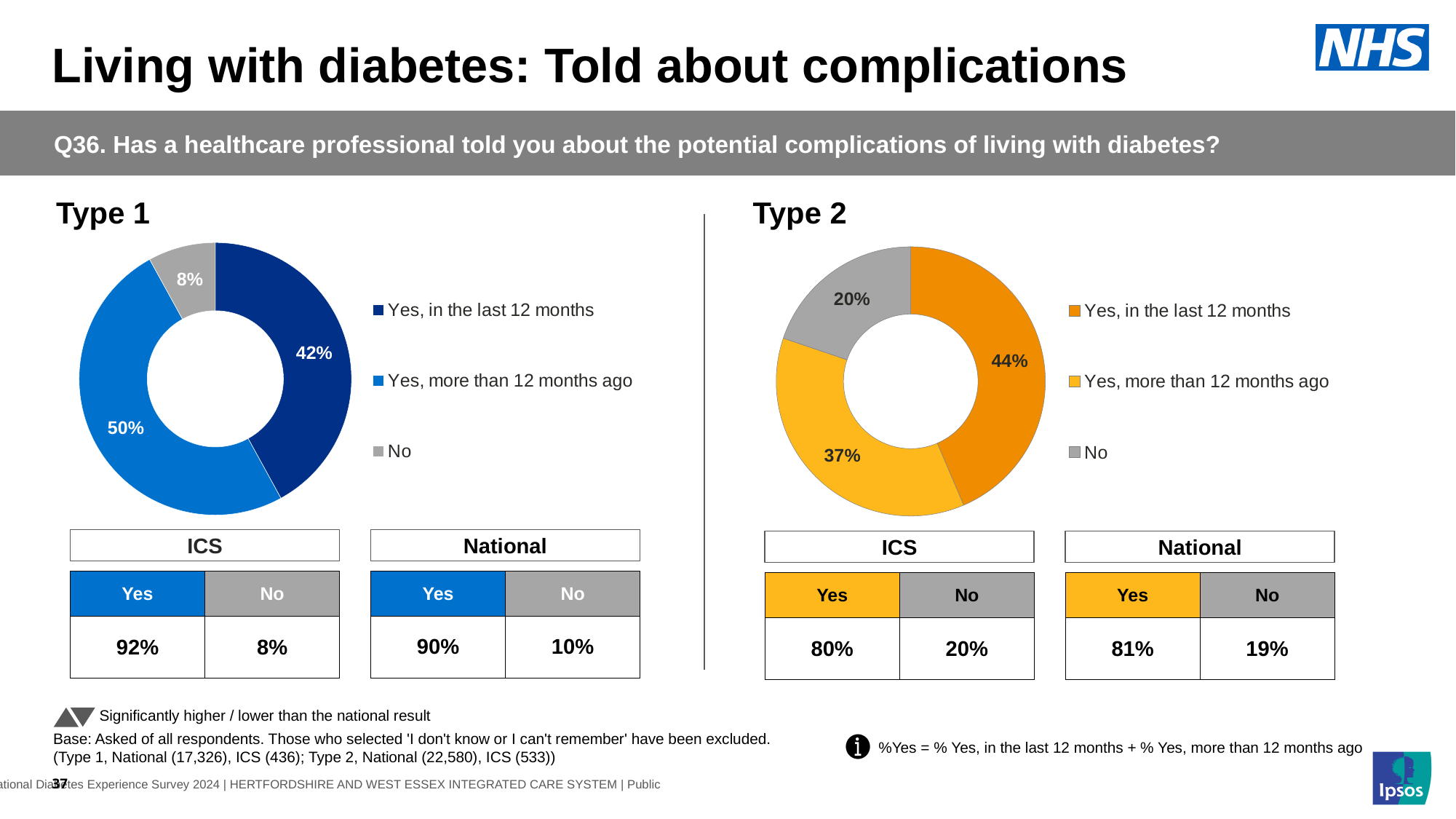
In the Type 2 chart, which category has the smallest share? No In the Type 1 chart, which category has the largest share? Yes, more than 12 months ago In the Type 2 chart, what percentage of respondents answered 'No'? 20% In the Type 1 chart, what percentage of respondents answered 'Yes, in the last 12 months'? 42% Which is larger in the Type 2 chart: 'Yes, in the last 12 months' or 'Yes, more than 12 months ago'? Yes, in the last 12 months In the Type 1 chart, what is the difference between the 'Yes, more than 12 months ago' share and the 'Yes, in the last 12 months' share? 8% In the Type 2 chart, which category has the largest share? Yes, in the last 12 months How many categories does the legend of the Type 1 chart list? 3 In the Type 1 chart, what percentage of respondents answered 'No'? 8% In the Type 2 chart, what percentage of respondents answered 'Yes, more than 12 months ago'? 37% What kind of chart is used for Type 1 and Type 2? Doughnut (pie) chart In the Type 2 chart, what is the difference between the 'Yes, in the last 12 months' share and the 'No' share? 24%